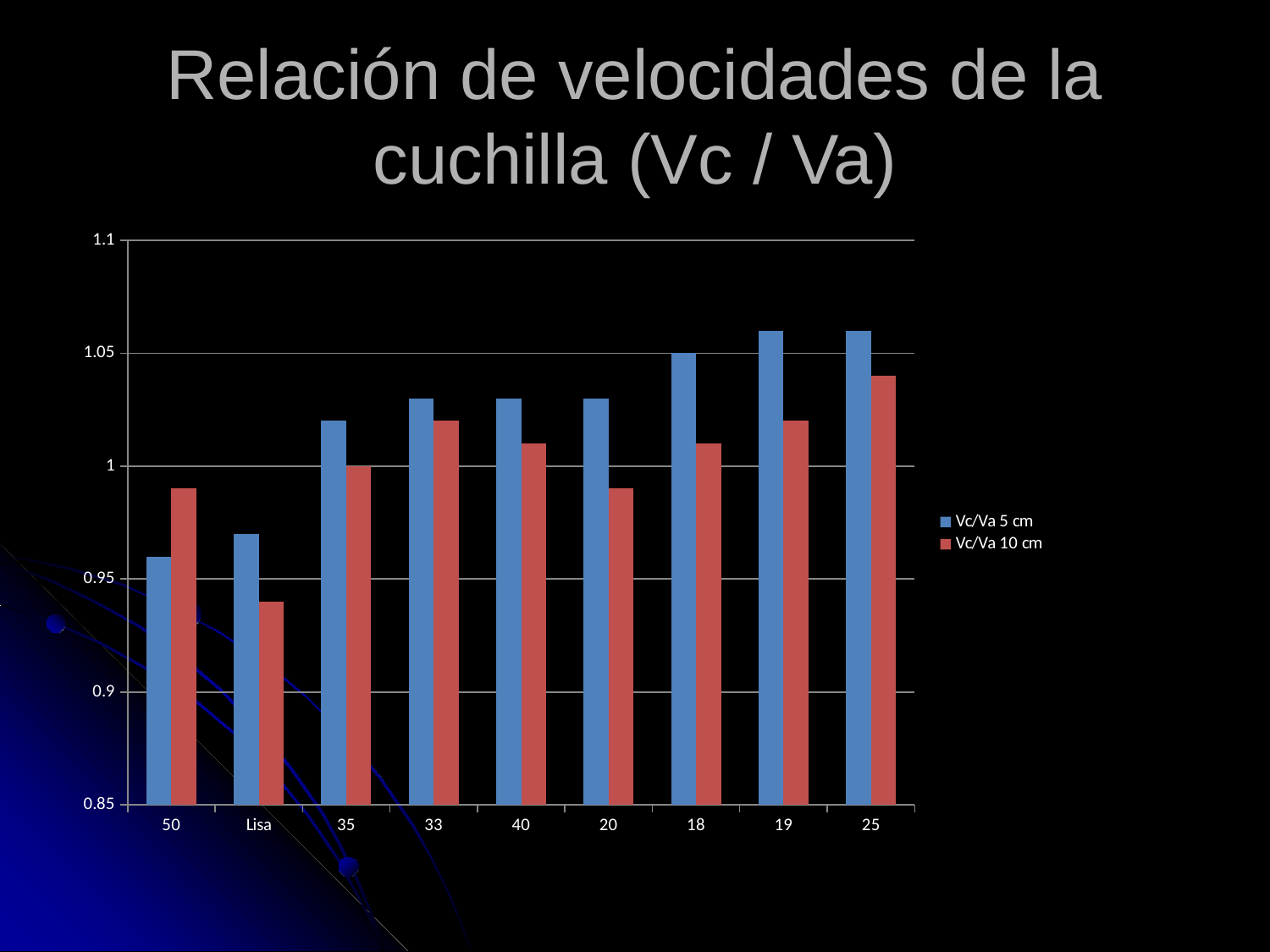
For category Lisa, which series has the larger value, Vc/Va 5 cm or Vc/Va 10 cm? Vc/Va 5 cm Which category has the highest Vc/Va 10 cm value? 25 Which category has the lowest Vc/Va 10 cm value? Lisa For category 50, which series has the larger value, Vc/Va 5 cm or Vc/Va 10 cm? Vc/Va 10 cm What is the Vc/Va 10 cm value for category 35? 1 Is the Vc/Va 10 cm value for category Lisa greater or less than 0.95? less What are the two series named in the legend? Vc/Va 5 cm and Vc/Va 10 cm How many series does the legend list? 2 What is the Vc/Va 5 cm value for category 18? 1.05 What kind of chart is shown on the slide? bar chart Is the Vc/Va 5 cm value for category 25 greater or less than 1.05? greater How many categories are shown on the x axis? 9